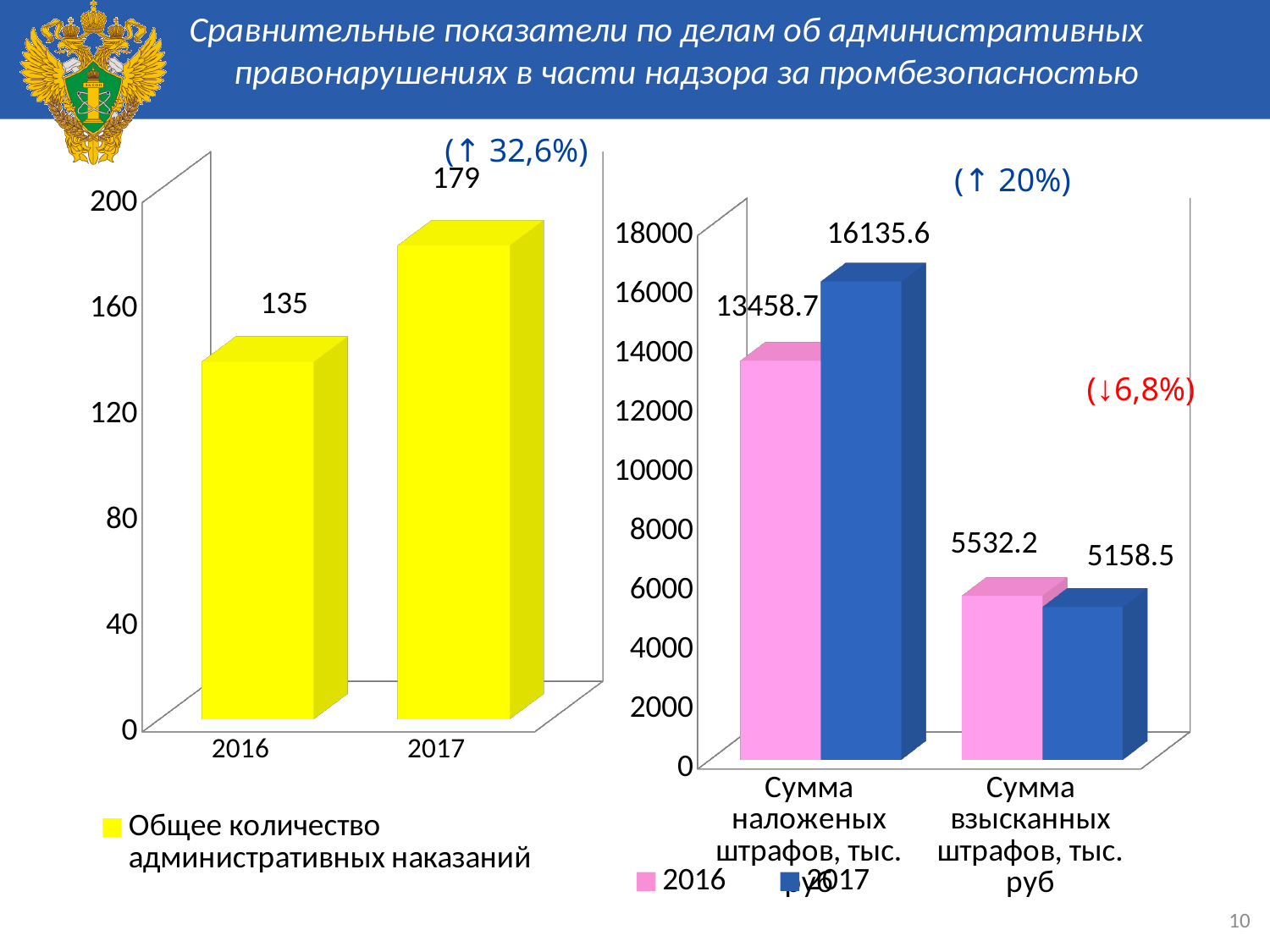
In the left chart, what is the value for 2017? 179 In the left chart, what is the legend entry for the yellow bars? Общее количество административных наказаний In the left chart, how many bars are plotted? 2 In the right chart, is the 2016 value for 'Сумма наложеных штрафов, тыс. руб' greater or less than 12000? greater In the left chart, which year has the higher value? 2017 In the left chart, what is the difference between the 2017 and 2016 values? 44 In the left chart, what is the value for 2016? 135 In the right chart, what is the 2017 value for 'Сумма наложеных штрафов, тыс. руб'? 16135.6 What kind of chart is the right chart? bar chart In the right chart, what is the 2016 value for 'Сумма взысканных штрафов, тыс. руб'? 5532.2 In the right chart, which year has the larger value for 'Сумма взысканных штрафов, тыс. руб'? 2016 In the right chart, how many series does the legend list? 2